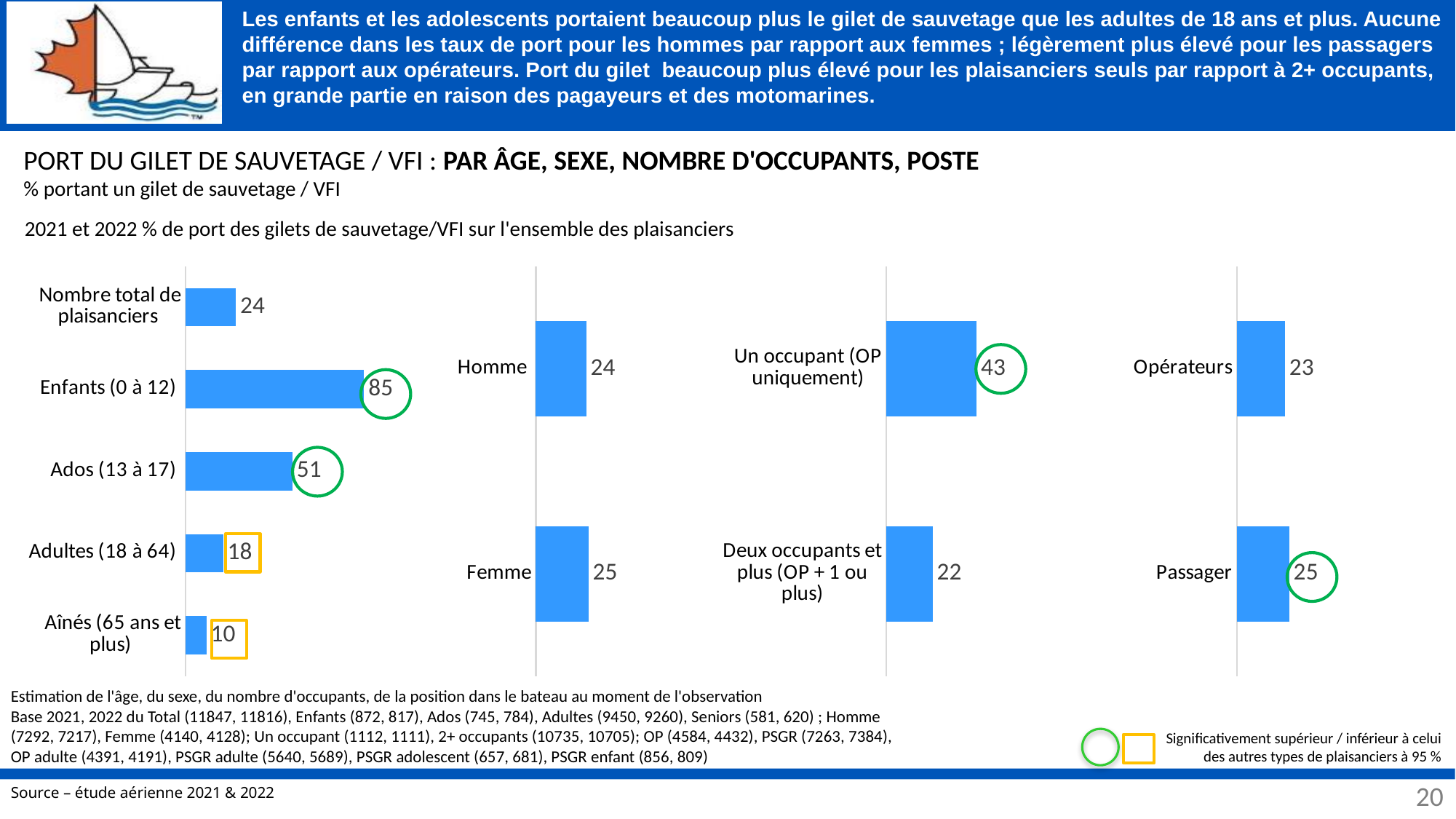
In the second chart from the left (by sex), what is the value for Femme? 25 In the leftmost chart (by age), what is the difference between Enfants (0 à 12) and Ados (13 à 17)? 34 In the rightmost chart (by position), which is larger, Opérateurs or Passager? Passager In the rightmost chart (by position), what is the value for Opérateurs? 23 In the third chart from the left (by number of occupants), what is the difference between Un occupant and Deux occupants et plus? 21 In the leftmost chart (by age), how many categories are shown? 5 In the third chart from the left (by number of occupants), what is the value for Un occupant (OP uniquement)? 43 What type of chart is the leftmost chart (by age)? Bar chart In the leftmost chart (by age), what is the value for Enfants (0 à 12)? 85 In the leftmost chart (by age), which category has the lowest value? Aînés (65 ans et plus) In the second chart from the left (by sex), which is larger, Homme or Femme? Femme In the leftmost chart (by age), which category has the highest value? Enfants (0 à 12)